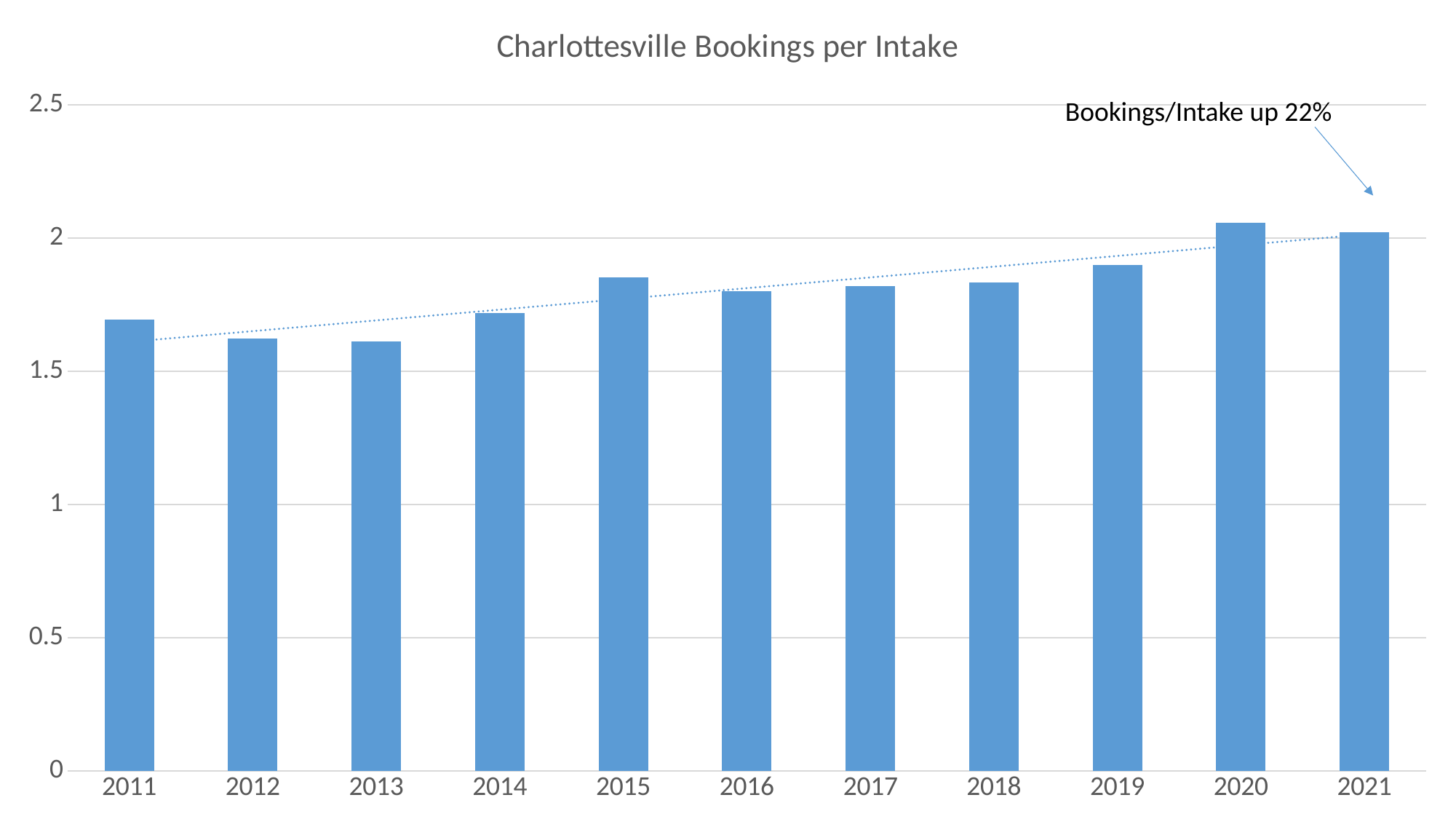
Is the value for 2020 greater or less than 2? greater Which is larger, the value for 2011 or the value for 2012? 2011 Do the values generally rise or fall from 2011 to 2021? rise What kind of chart is shown on the slide? bar chart Is the value for 2015 greater or less than 2? less What is the title of the chart? Charlottesville Bookings per Intake How many years are plotted on the x axis? 11 Is the value for 2011 greater or less than 1.5? greater What does the annotation text on the chart say? Bookings/Intake up 22% Which year has the highest bookings per intake? 2020 Which is larger, the value for 2014 or the value for 2015? 2015